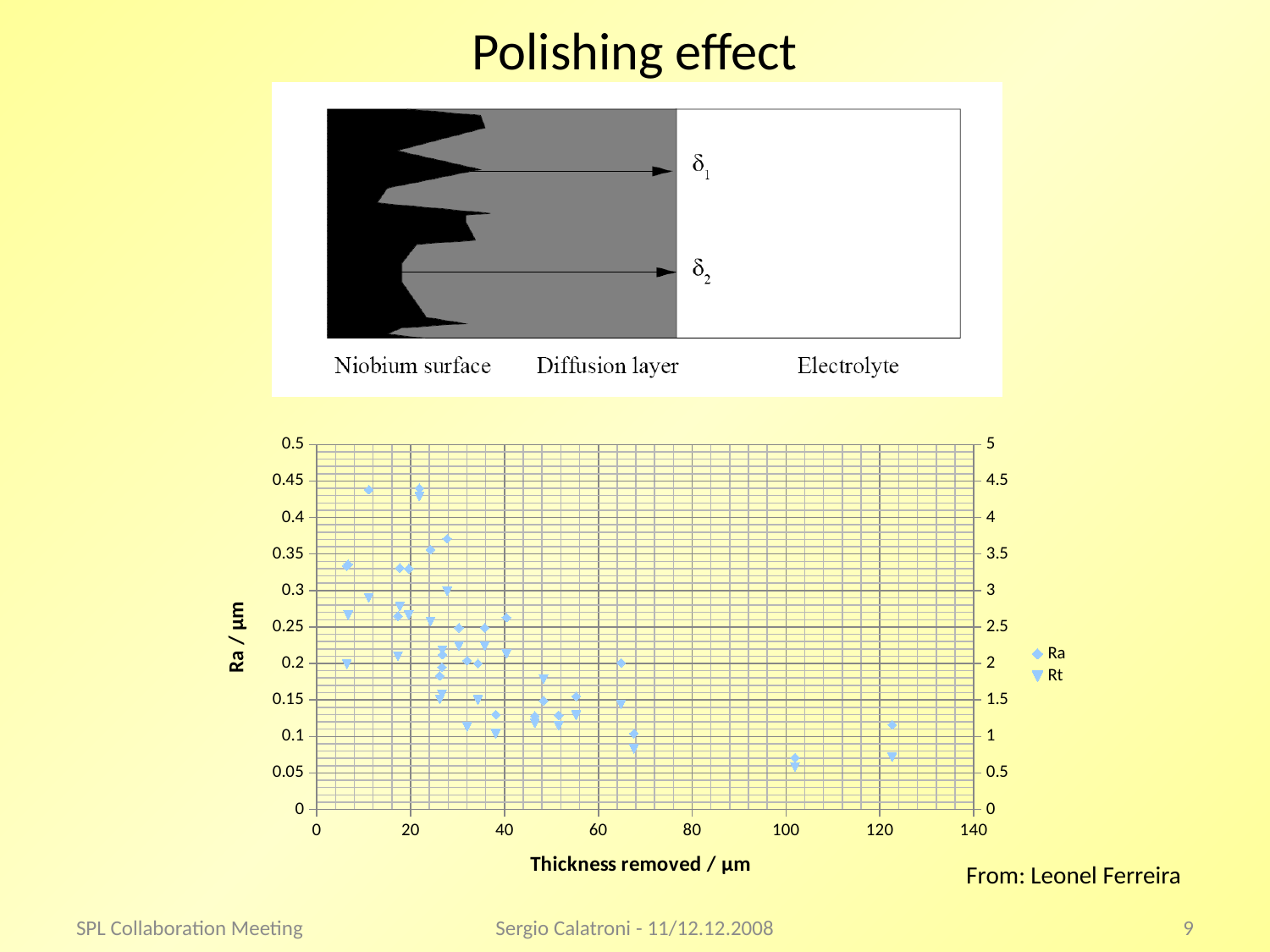
Is the Ra value at about 28 µm thickness removed (the highest point there) greater or less than 0.35? greater What are the two series named in the chart legend? Ra and Rt Is the Ra value at about 11 µm thickness removed greater or less than 0.4? greater Is the Ra value at about 102 µm thickness removed greater or less than 0.1? less How many series does the chart legend list? 2 What kind of chart is shown on the slide? scatter chart What is the title of the x axis of the chart? Thickness removed / µm Is the Ra value at about 102 µm thickness removed greater or less than the Ra value at about 122 µm? less What is the maximum value shown on the left y axis of the chart? 0.5 Overall, do the Ra values rise or fall as thickness removed increases? fall